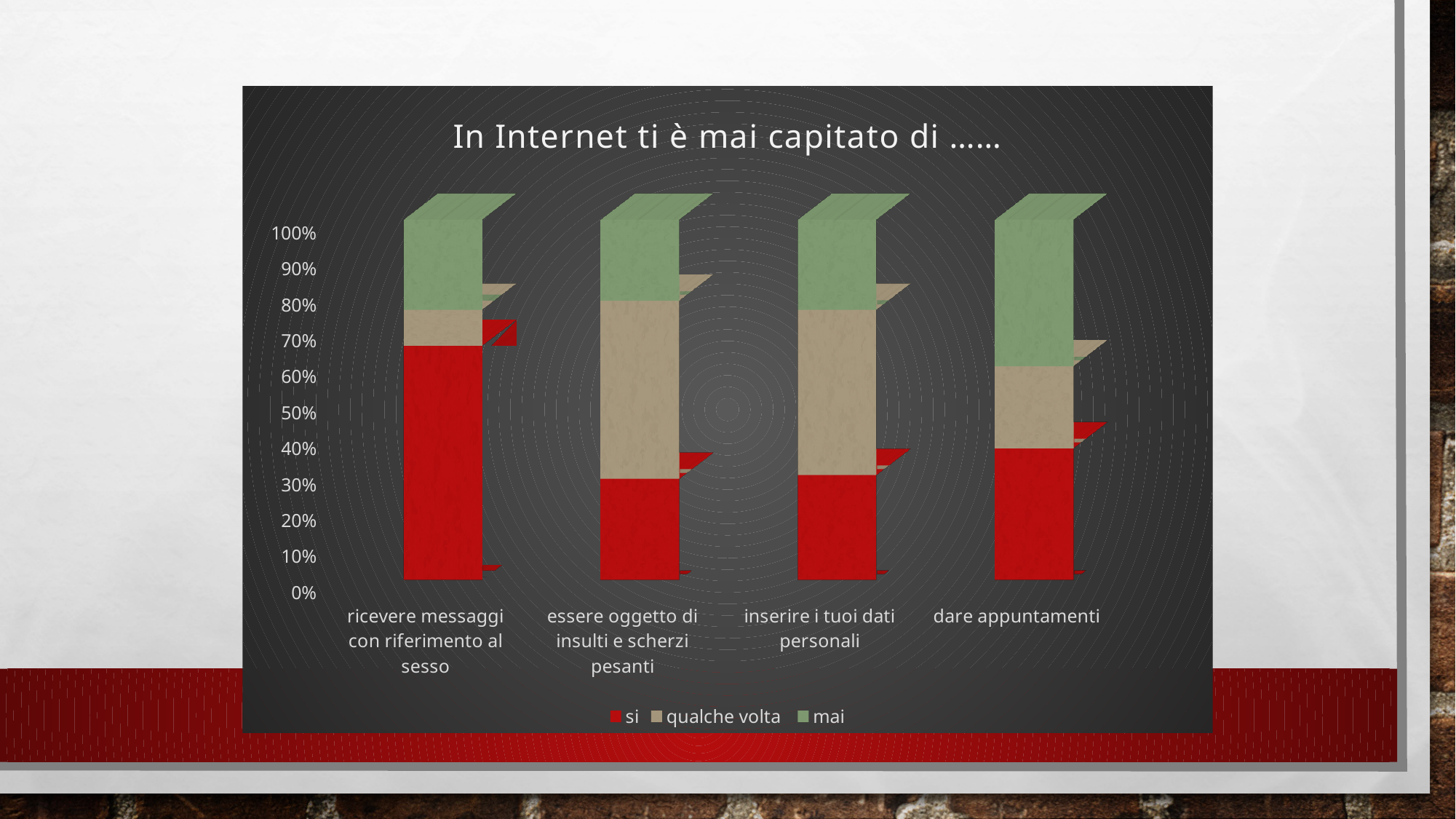
Which category has the lowest value for the 'qualche volta' series? ricevere messaggi con riferimento al sesso How many series does the legend list? 3 Is the 'si' value for 'essere oggetto di insulti e scherzi pesanti' greater or less than 40%? less Which has the larger 'si' value: 'ricevere messaggi con riferimento al sesso' or 'dare appuntamenti'? ricevere messaggi con riferimento al sesso Which has the larger 'qualche volta' value: 'essere oggetto di insulti e scherzi pesanti' or 'ricevere messaggi con riferimento al sesso'? essere oggetto di insulti e scherzi pesanti Which category has the highest value for the 'si' series? ricevere messaggi con riferimento al sesso How many categories are shown on the x axis of the chart? 4 What kind of chart is shown on the slide? stacked bar chart What is the title of the chart? In Internet ti è mai capitato di …… Which category has the highest value for the 'mai' series? dare appuntamenti Is the 'si' value for 'ricevere messaggi con riferimento al sesso' greater or less than 60%? greater Which series are listed in the legend? si, qualche volta, mai